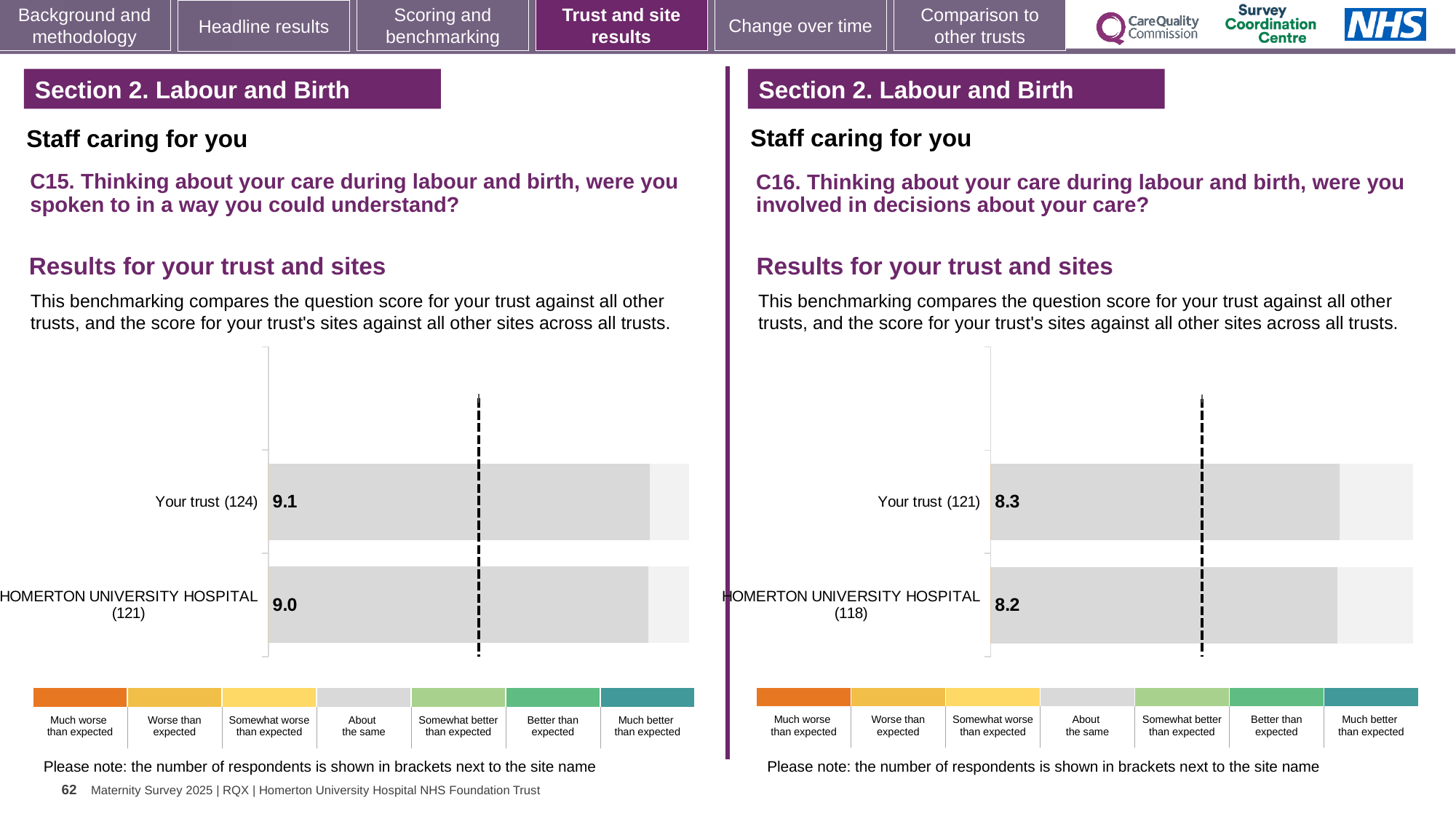
In the C16 chart on the right, what is the score for Homerton University Hospital (118)? 8.2 In the C15 chart on the left, what is the score for Your trust (124)? 9.1 How many respondents are shown in brackets for Homerton University Hospital in the C16 chart on the right? 118 How many bars are plotted in the C15 chart on the left? 2 In the C16 chart on the right, what is the score for Your trust (121)? 8.3 In the C15 chart on the left, which bar has the highest score? Your trust (124) In the C16 chart on the right, which has the higher score: Your trust or Homerton University Hospital? Your trust In the C15 chart on the left, what is the score for Homerton University Hospital (121)? 9.0 How many categories does the colour key below the C15 chart on the left list? 7 In the C16 chart on the right, what is the difference between the Your trust score and the Homerton University Hospital score? 0.1 What type of chart is used for the C16 results on the right? Bar chart In the C15 chart on the left, what is the difference between the Your trust score and the Homerton University Hospital score? 0.1